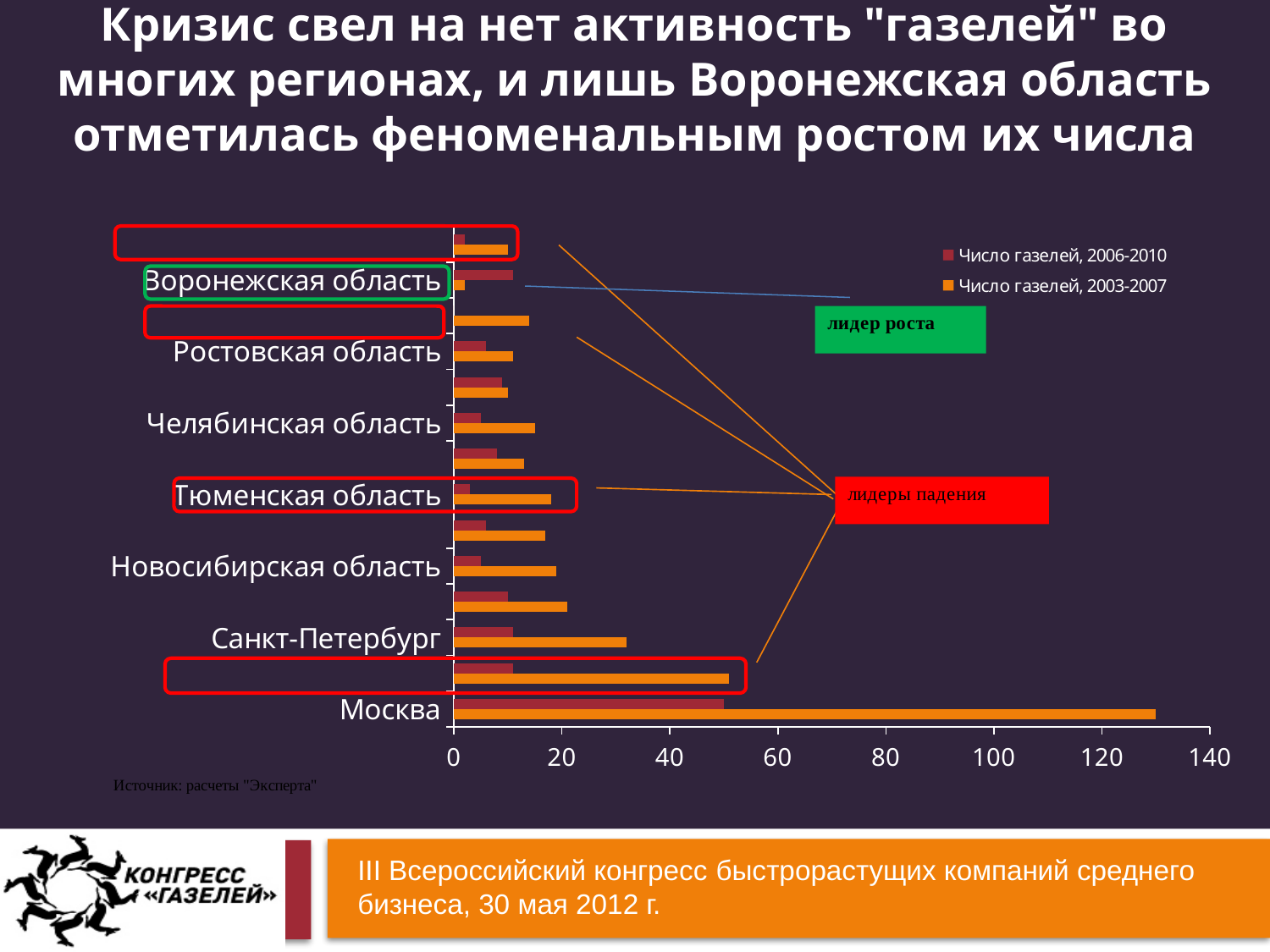
What is the maximum value shown on the horizontal axis of the chart? 140 For Воронежская область, which series has the larger value: "Число газелей, 2006-2010" or "Число газелей, 2003-2007"? Число газелей, 2006-2010 Which region is marked on the chart with the annotation "лидер роста"? Воронежская область Which region has the highest value for the series "Число газелей, 2003-2007"? Москва Which region has the highest value for the series "Число газелей, 2006-2010"? Москва Is the value for Москва in the series "Число газелей, 2003-2007" greater or less than 120? greater What kind of chart is shown on the slide? bar chart How many series does the legend list? 2 For Москва, which series has the larger value: "Число газелей, 2006-2010" or "Число газелей, 2003-2007"? Число газелей, 2003-2007 Is the value for Воронежская область in the series "Число газелей, 2006-2010" greater or less than 20? less Is the value for Москва in the series "Число газелей, 2006-2010" greater or less than 40? greater